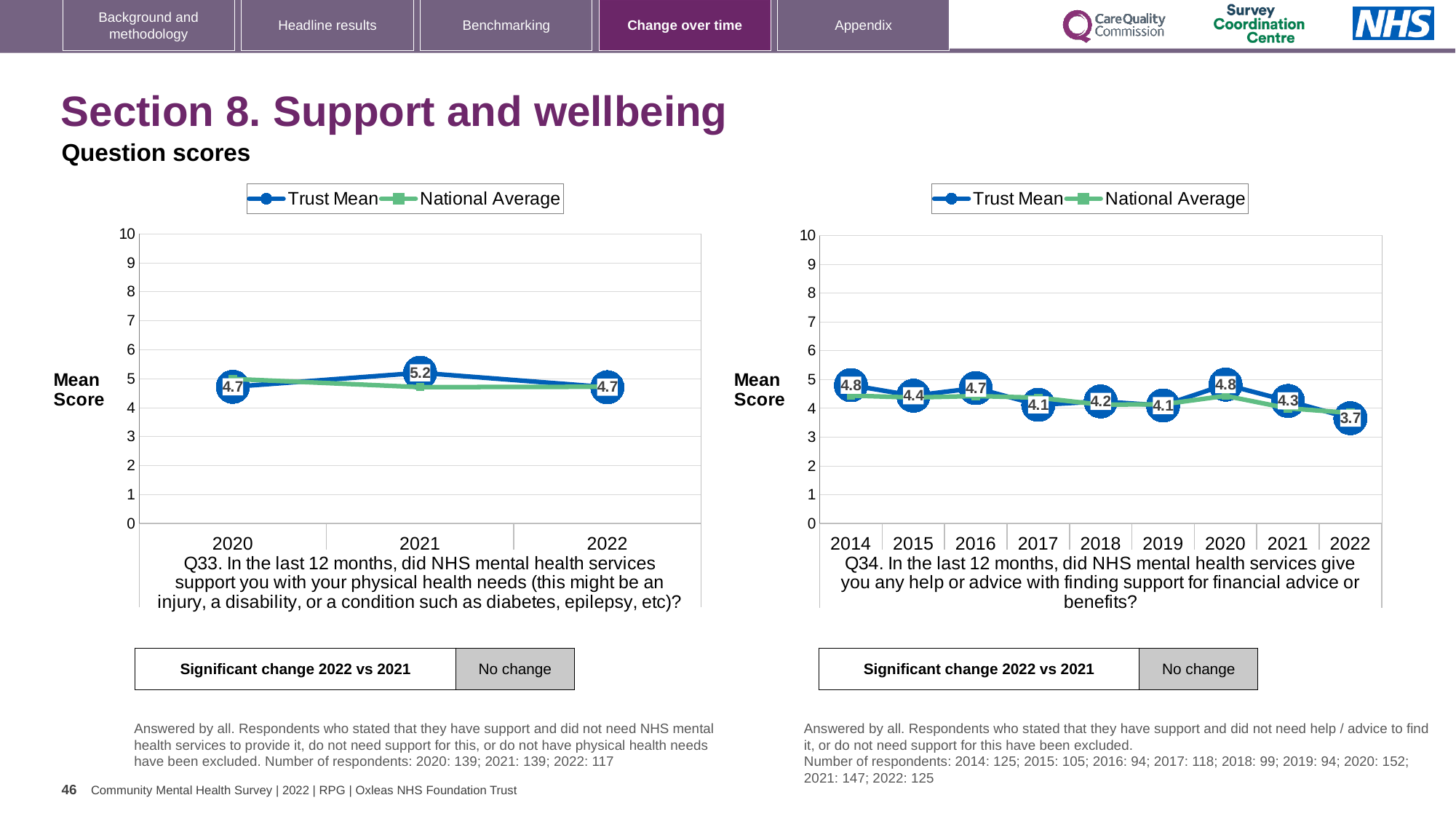
In the right chart (Q34), is the Trust Mean higher in 2020 or in 2021? 2020 In the left chart (Q33), what is the Trust Mean for 2021? 5.2 What type of chart is the right chart (Q34)? Line chart In the right chart (Q34), what is the difference between the Trust Mean in 2020 and in 2022? 1.1 In the left chart (Q33), what is the difference between the Trust Mean in 2021 and in 2022? 0.5 In the left chart (Q33), how many years are shown on the x axis? 3 In the left chart (Q33), what is the Trust Mean for 2022? 4.7 In the right chart (Q34), which year has the lowest Trust Mean? 2022 In the right chart (Q34), how many series does the legend list? 2 In the right chart (Q34), what is the Trust Mean for 2014? 4.8 In the right chart (Q34), what is the Trust Mean for 2022? 3.7 In the left chart (Q33), which year has the highest Trust Mean? 2021